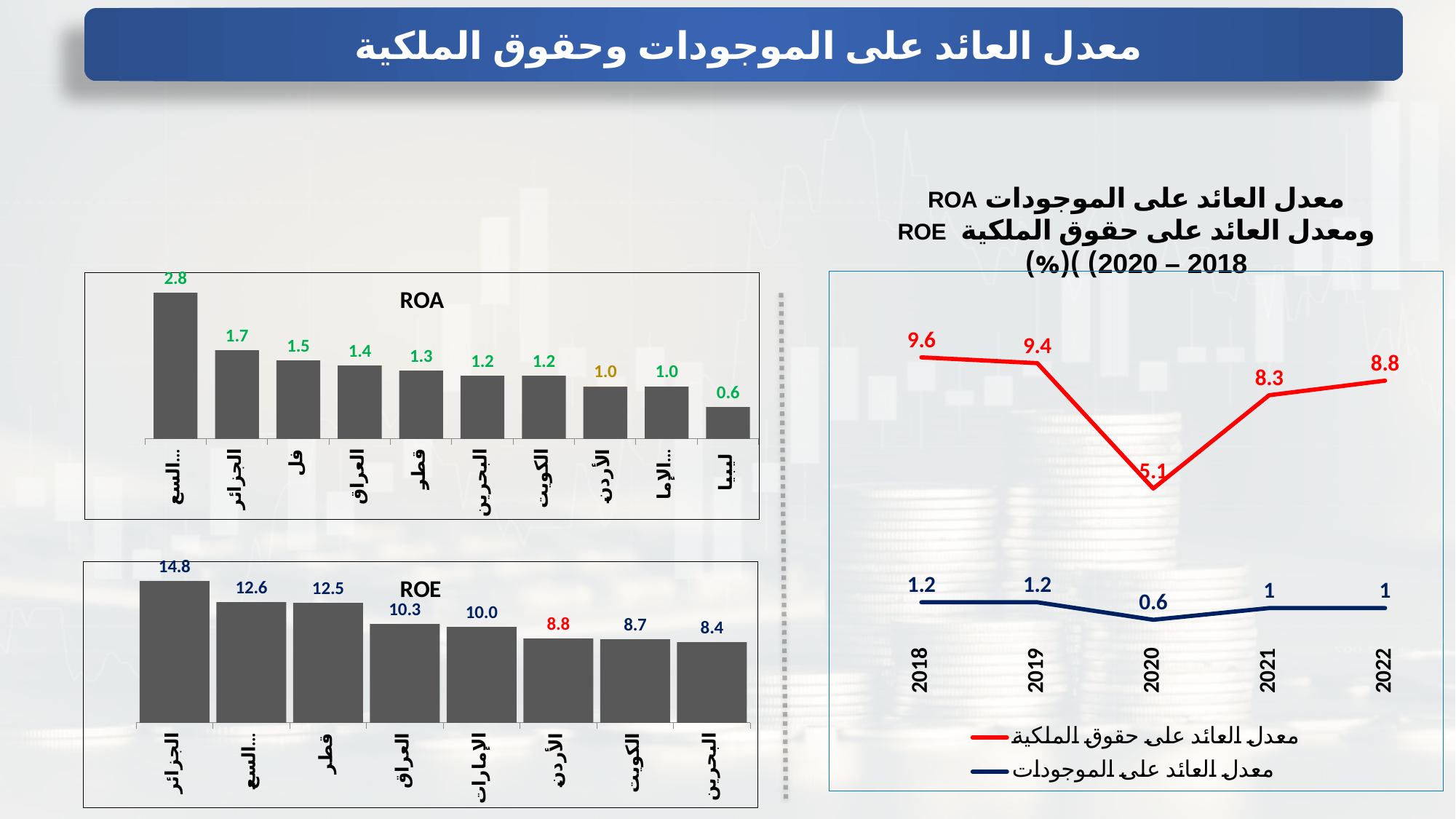
In the ROE bar chart, which category has the highest value? الجزائر In the ROA bar chart, which category has the lowest value? ليبيا In the ROA bar chart, what is the value for ليبيا? 0.6 In the ROE bar chart, what is the value for قطر? 12.5 In the ROA bar chart, how many categories are shown? 10 In the ROE bar chart, how many categories are shown? 8 In the line chart on the right, what is the value of the red line (معدل العائد على حقوق الملكية) in 2020? 5.1 In the line chart on the right, how many series does the legend list? 2 In the ROA bar chart, what is the value for العراق? 1.4 In the ROE bar chart, which is larger, the value for العراق or the value for الكويت? العراق In the ROE bar chart, what is the difference between the values for الجزائر and البحرين? 6.4 In the line chart on the right, what is the difference between the red line's values in 2018 and 2022? 0.8